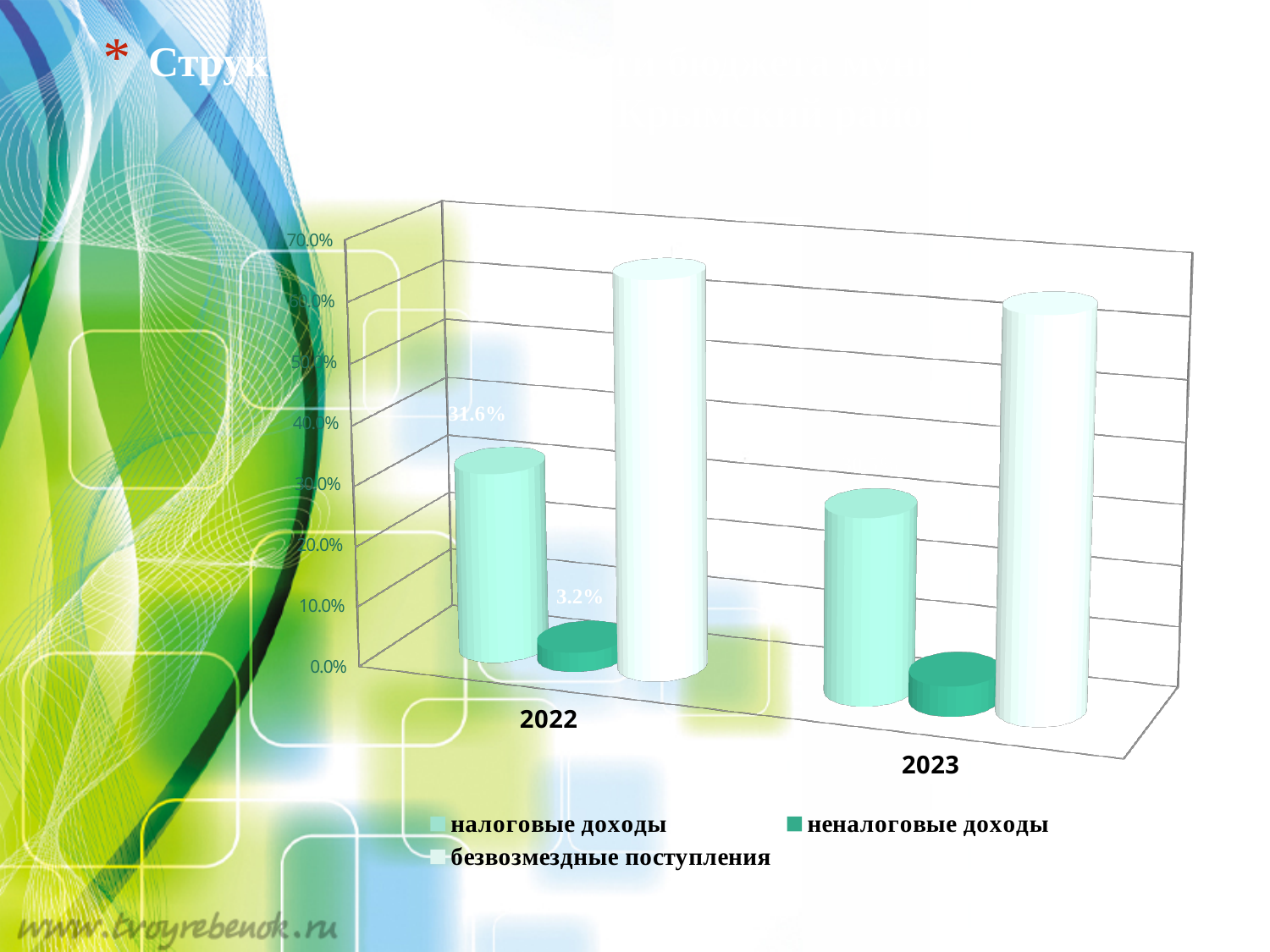
What is the difference between налоговые доходы and неналоговые доходы in 2022? 28.4 percentage points What is the value for неналоговые доходы in 2022? 3.2% Is the value for налоговые доходы in 2023 greater or less than 40.0%? less What is the value for налоговые доходы in 2022? 31.6% Which series has the highest value in 2022? безвозмездные поступления Which series has the lowest value in 2023? неналоговые доходы Is the value for безвозмездные поступления in 2023 greater or less than 50.0%? greater Is the value for безвозмездные поступления in 2022 greater or less than 50.0%? greater How many series does the legend list? 3 How many years are shown on the x axis? 2